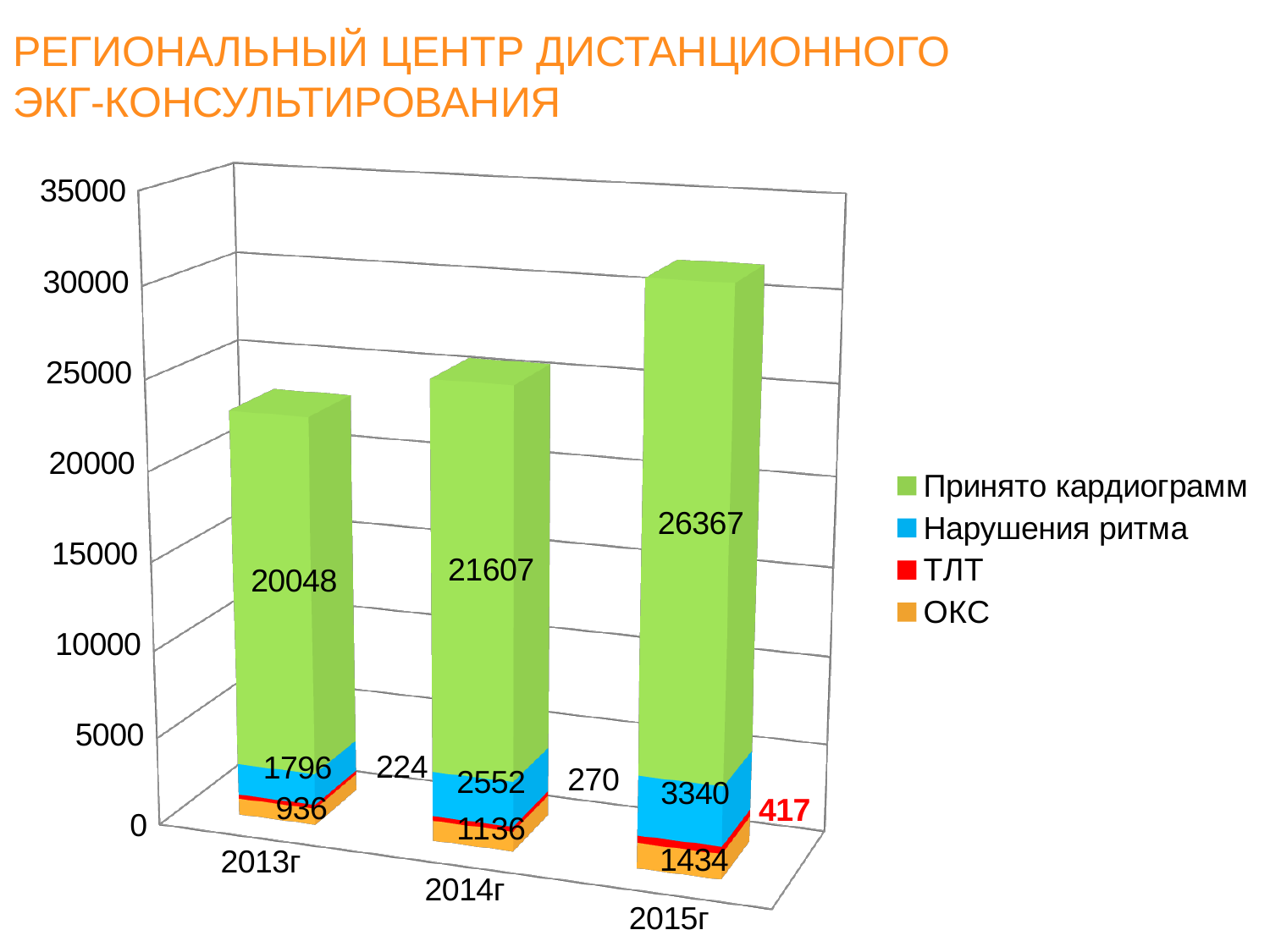
What is the total of the stacked bar for 2013г? 23004 Which year has the lowest value for ОКС? 2013г What is the value of ОКС for 2015г? 1434 What is the difference between the Принято кардиограмм values for 2015г and 2014г? 4760 What is the value of Принято кардиограмм for 2015г? 26367 What is the value of ТЛТ for 2013г? 224 Which is larger: Нарушения ритма for 2013г or ОКС for 2015г? Нарушения ритма for 2013г Which year has the highest value for Принято кардиограмм? 2015г What is the value of Нарушения ритма for 2014г? 2552 What kind of chart is shown on the slide? Stacked bar chart How many years are shown on the x axis? 3 How many series does the legend list? 4